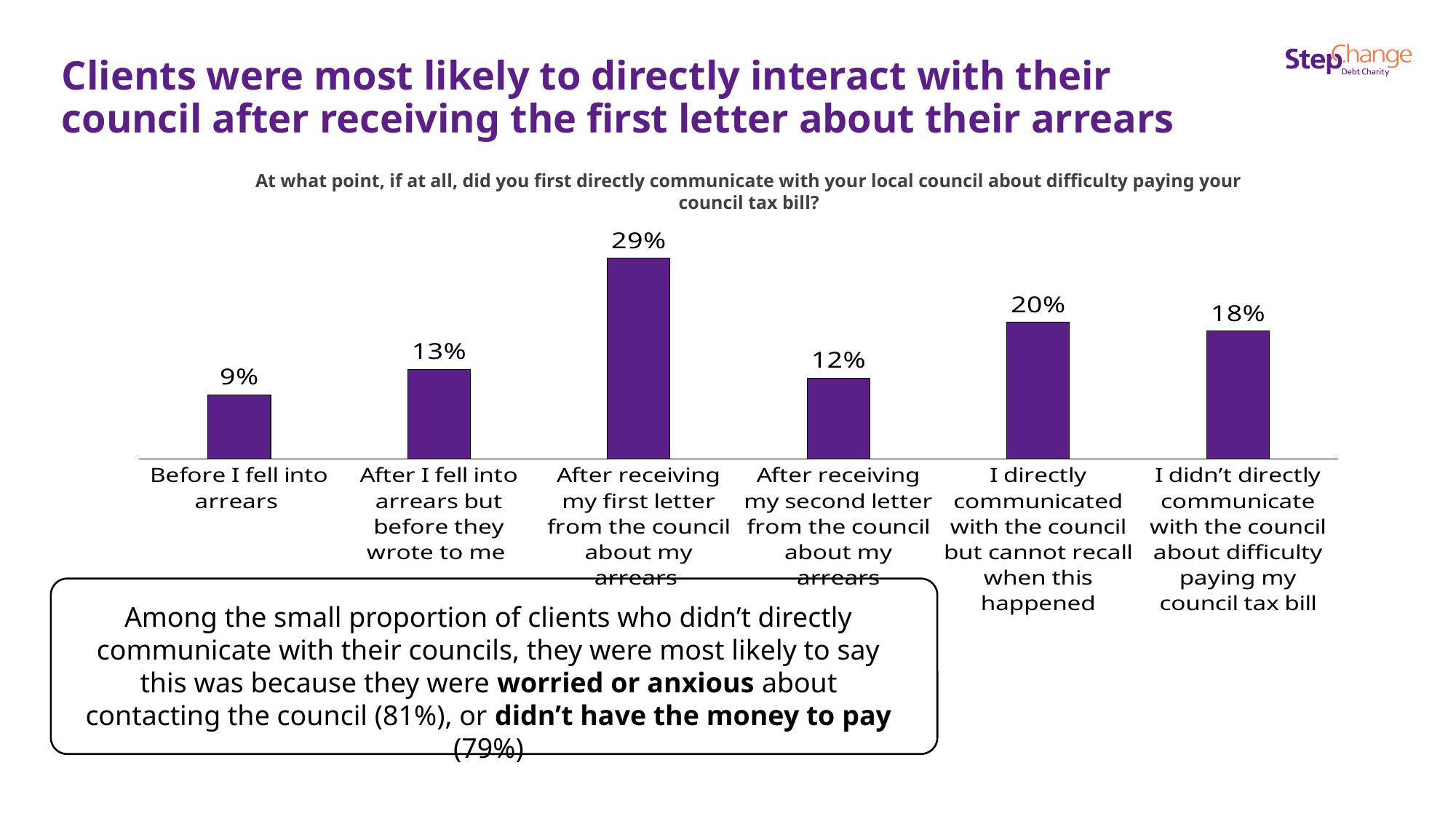
What question is the chart titled with? At what point, if at all, did you first directly communicate with your local council about difficulty paying your council tax bill? Which category has the highest value in the chart? After receiving my first letter from the council about my arrears What is the difference between the value for 'I directly communicated with the council but cannot recall when this happened' and 'I didn't directly communicate with the council about difficulty paying my council tax bill'? 2% What percentage of clients first directly communicated with their council after receiving their first letter from the council about their arrears? 29% How many categories are shown in the chart? 6 What is the difference between the value for 'After receiving my first letter from the council about my arrears' and 'After receiving my second letter from the council about my arrears'? 17% What percentage of clients directly communicated with the council but cannot recall when this happened? 20% What percentage of clients said they didn't directly communicate with the council about difficulty paying their council tax bill? 18% Which is larger: the value for 'After I fell into arrears but before they wrote to me' or 'After receiving my second letter from the council about my arrears'? After I fell into arrears but before they wrote to me What kind of chart is shown on the slide? Bar chart What percentage of clients first directly communicated with their council before they fell into arrears? 9% Which category has the lowest value in the chart? Before I fell into arrears